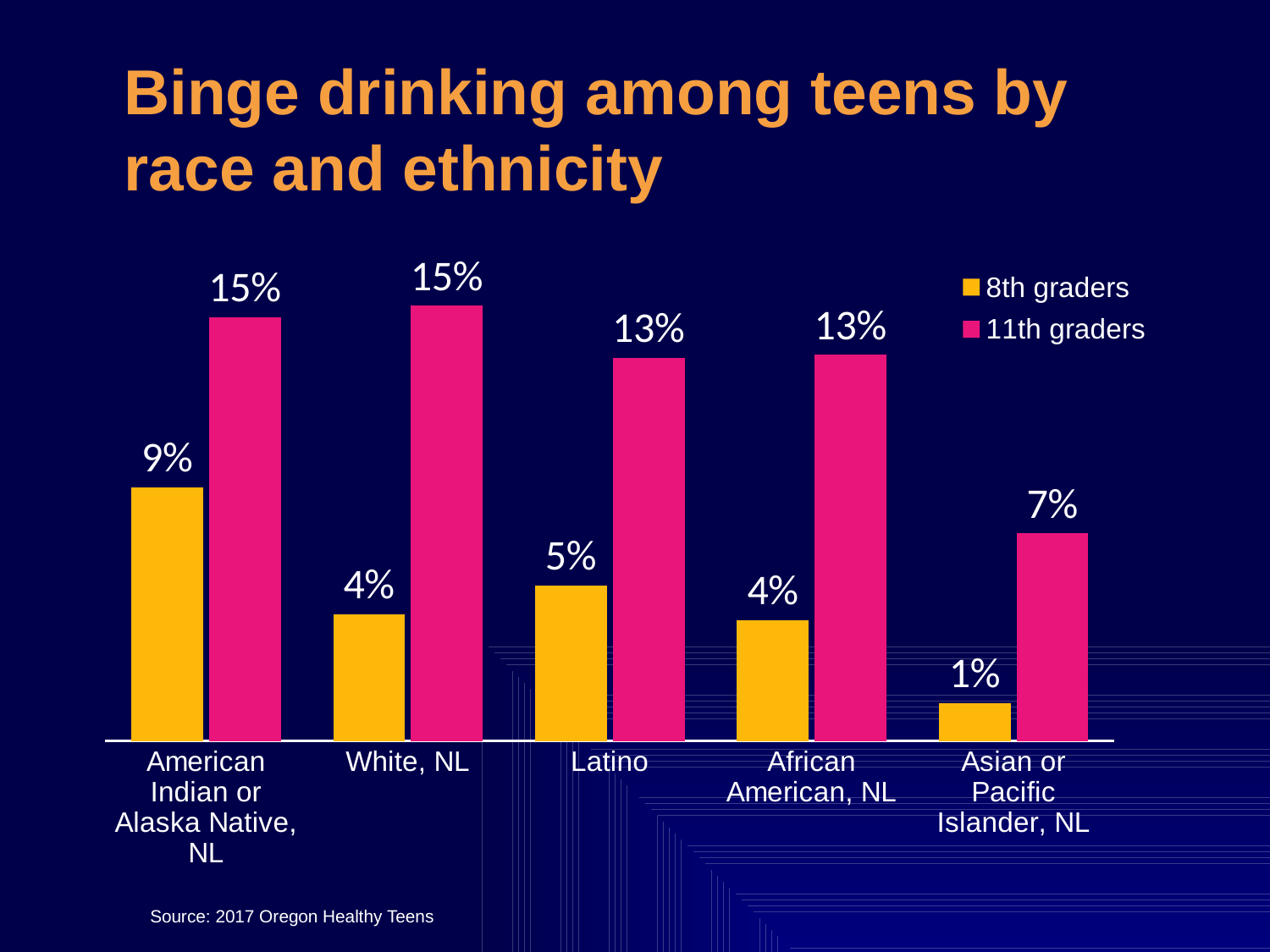
How many race and ethnicity categories are shown on the chart? 5 What colour are the bars for 11th graders? Pink Which is larger: the 8th graders value for Latino or the 8th graders value for African American, NL? Latino What is the value for 8th graders in the Asian or Pacific Islander, NL category? 1% What is the difference between the 11th graders and 8th graders values in the White, NL category? 11% Which category has the highest value for 8th graders? American Indian or Alaska Native, NL Which category has the lowest value for 11th graders? Asian or Pacific Islander, NL What is the value for 11th graders in the Asian or Pacific Islander, NL category? 7% What is the value for 8th graders in the American Indian or Alaska Native, NL category? 9% What is the value for 11th graders in the Latino category? 13% How many series does the legend list? 2 What kind of chart is shown on the slide? Bar chart